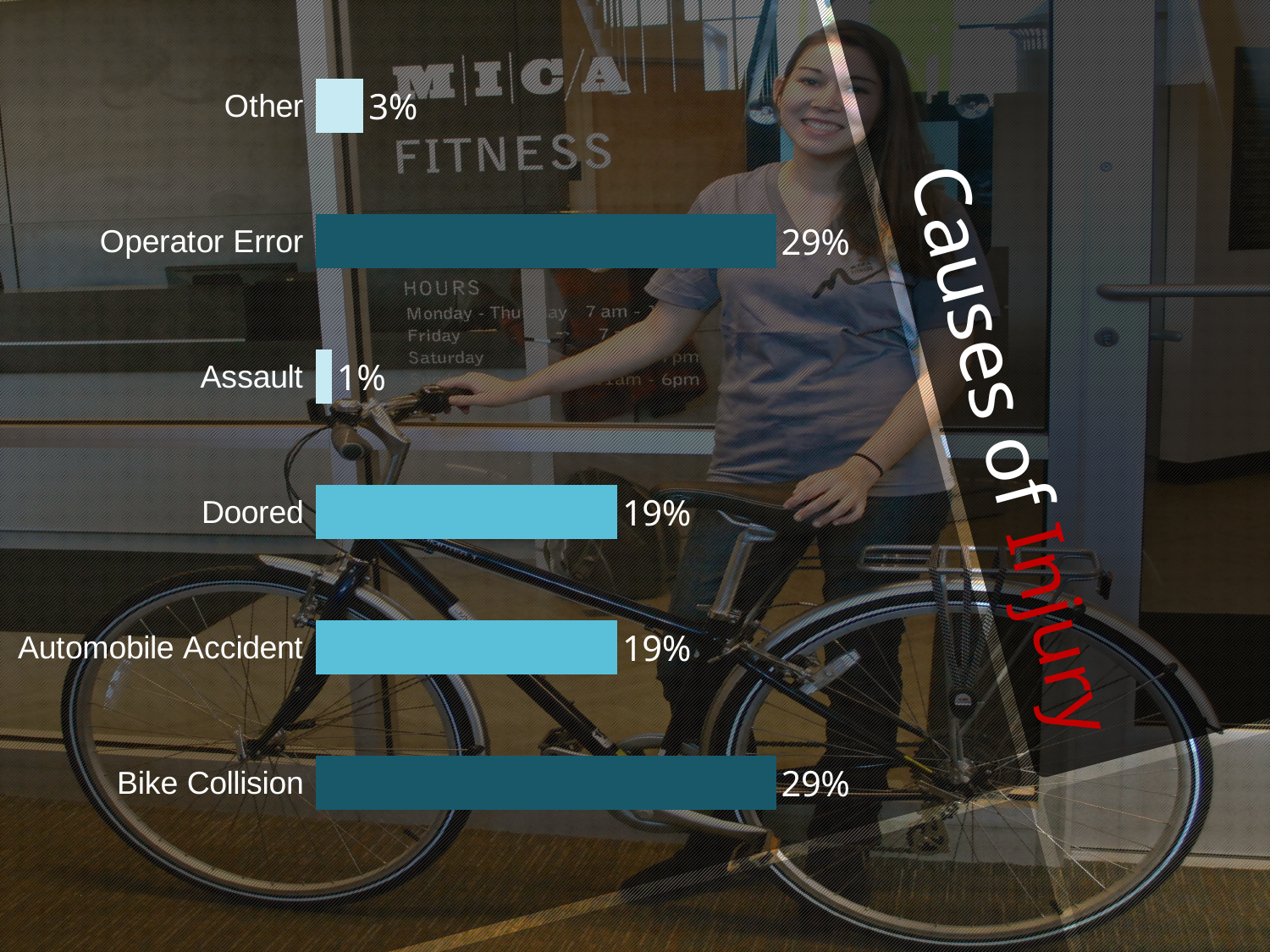
What is the difference between the values for Operator Error and Doored? 10% Which is larger, the value for Automobile Accident or the value for Other? Automobile Accident How many categories are shown in the chart? 6 What is the title of the chart? Causes of Injury What is the value for Other? 3% What is the value for Bike Collision? 29% What is the value for Doored? 19% What is the value for Operator Error? 29% What kind of chart is shown on the slide? Bar chart What is the value for Assault? 1% What is the difference between the values for Other and Assault? 2% Which category has the lowest value? Assault